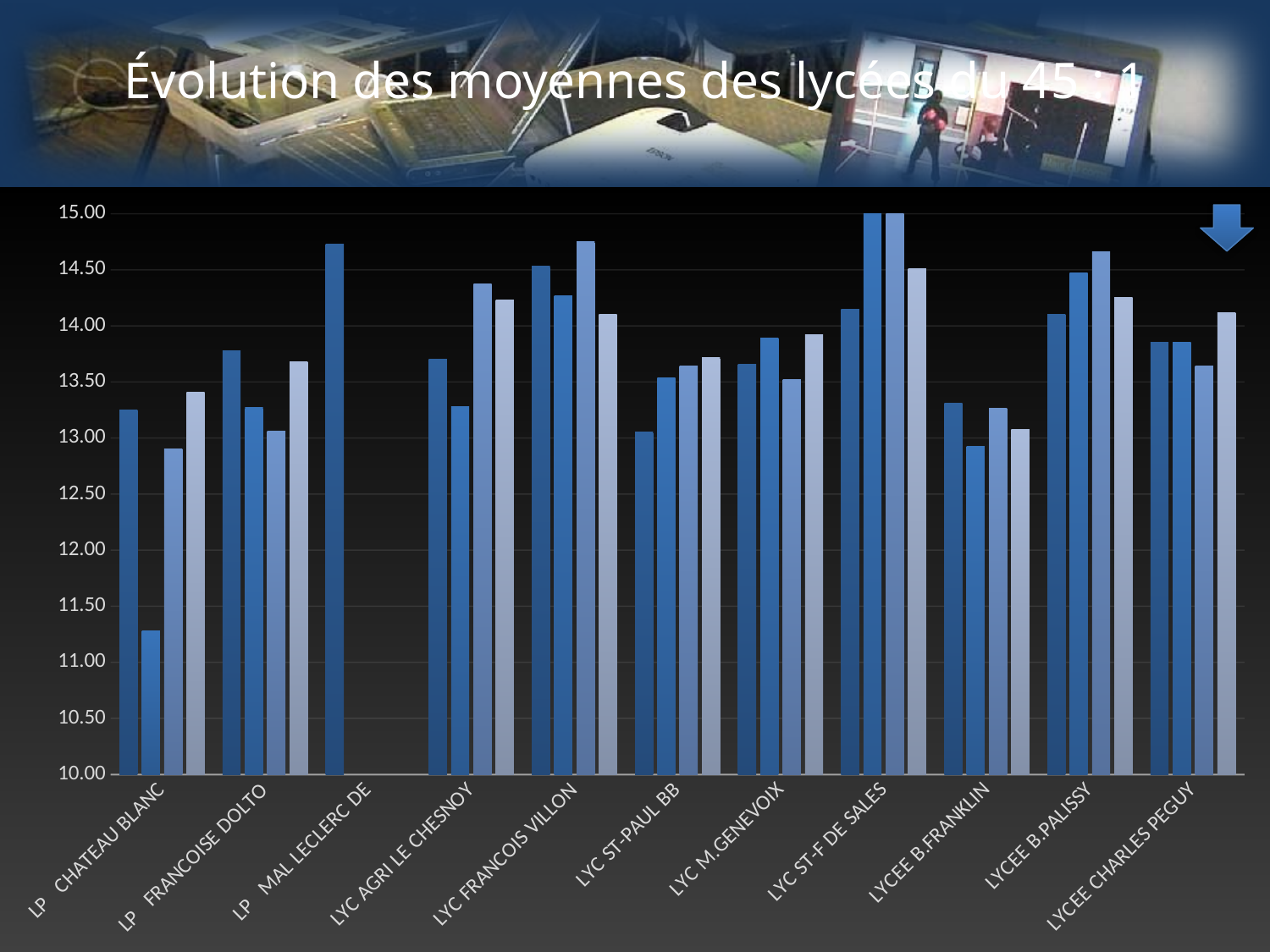
How many lycées (categories) are shown on the x axis of the chart? 11 What is the lowest value shown on the y axis of the chart? 10.00 Is the first bar for LYC FRANCOIS VILLON greater or less than 14.00? greater Which lycée has the tallest bars in the chart? LYC ST-F DE SALES Which is larger: the single bar for LP MAL LECLERC DE or the first bar for LP CHATEAU BLANC? LP MAL LECLERC DE Which lycée has the lowest bar in the chart? LP CHATEAU BLANC Is the single bar for LP MAL LECLERC DE greater or less than 14.50? greater Which is larger: the first bar for LYC ST-F DE SALES or the first bar for LYCEE B.FRANKLIN? LYC ST-F DE SALES Is the first bar for LYCEE B.FRANKLIN greater or less than 13.50? less What is the title of the chart? Évolution des moyennes des lycées du 45 : 1 What kind of chart is shown on the slide? bar chart